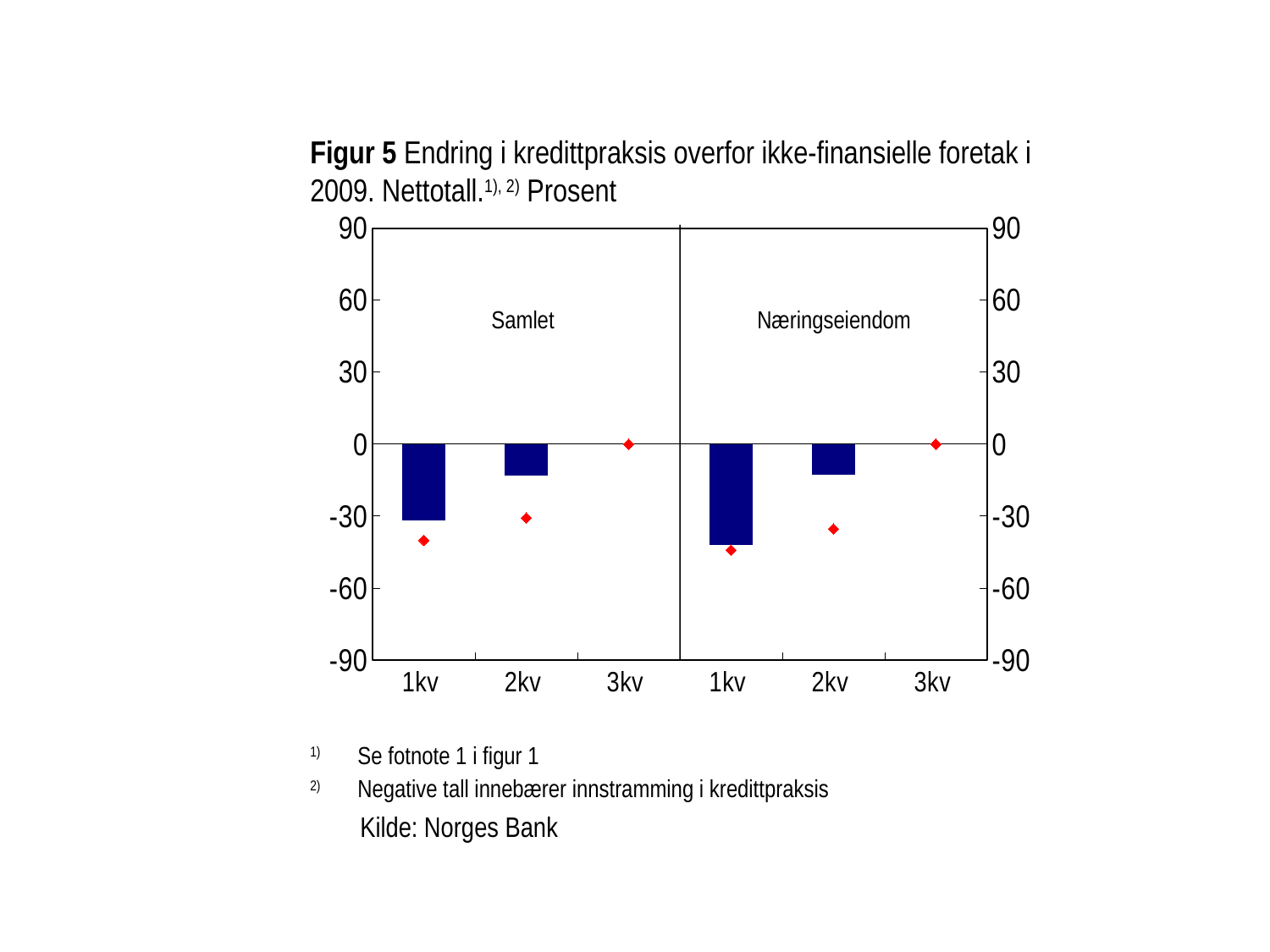
What are the labels of the two panels in the chart? Samlet and Næringseiendom How many quarter categories are shown in the Samlet panel? 3 In the Samlet panel, which bar is larger, 1kv or 2kv? 2kv What kind of chart is shown on the slide? combination bar and line chart (bars with red diamond markers) Is the red diamond value for 1kv in the Samlet panel greater or less than -30? less Which bar is lowest across both panels? 1kv in Næringseiendom Which 1kv bar is larger, Samlet or Næringseiendom? Samlet Is the bar value for 2kv in the Samlet panel greater or less than -30? greater Is the bar value for 1kv in the Næringseiendom panel greater or less than -30? less Do the bar values in the Samlet panel rise or fall from 1kv to 3kv? rise